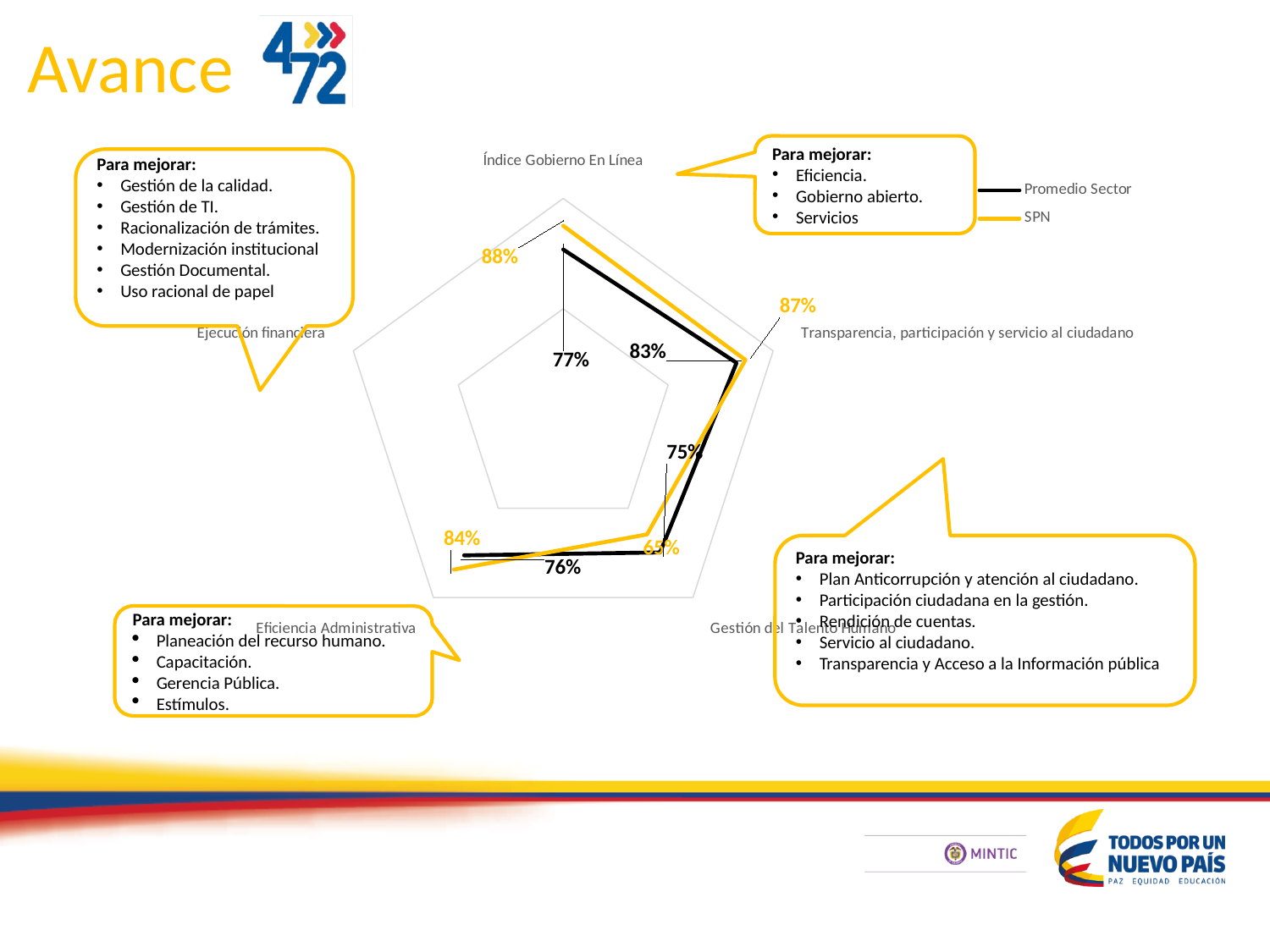
What is the SPN value for Índice Gobierno En Línea? 88% What is the Promedio Sector value for Gestión del Talento Humano? 75% What is the Promedio Sector value for Transparencia, participación y servicio al ciudadano? 83% What is the Promedio Sector value for Eficiencia Administrativa? 76% What kind of chart is shown on the slide? Radar chart What are the two series named in the chart's legend? Promedio Sector and SPN What is the SPN value for Eficiencia Administrativa? 84% How many series does the chart's legend list? 2 By how many percentage points does SPN exceed Promedio Sector for Índice Gobierno En Línea? 11 percentage points For Transparencia, participación y servicio al ciudadano, which series has the higher value, SPN or Promedio Sector? SPN What is the SPN value for Transparencia, participación y servicio al ciudadano? 87% What is the Promedio Sector value for Índice Gobierno En Línea? 77%